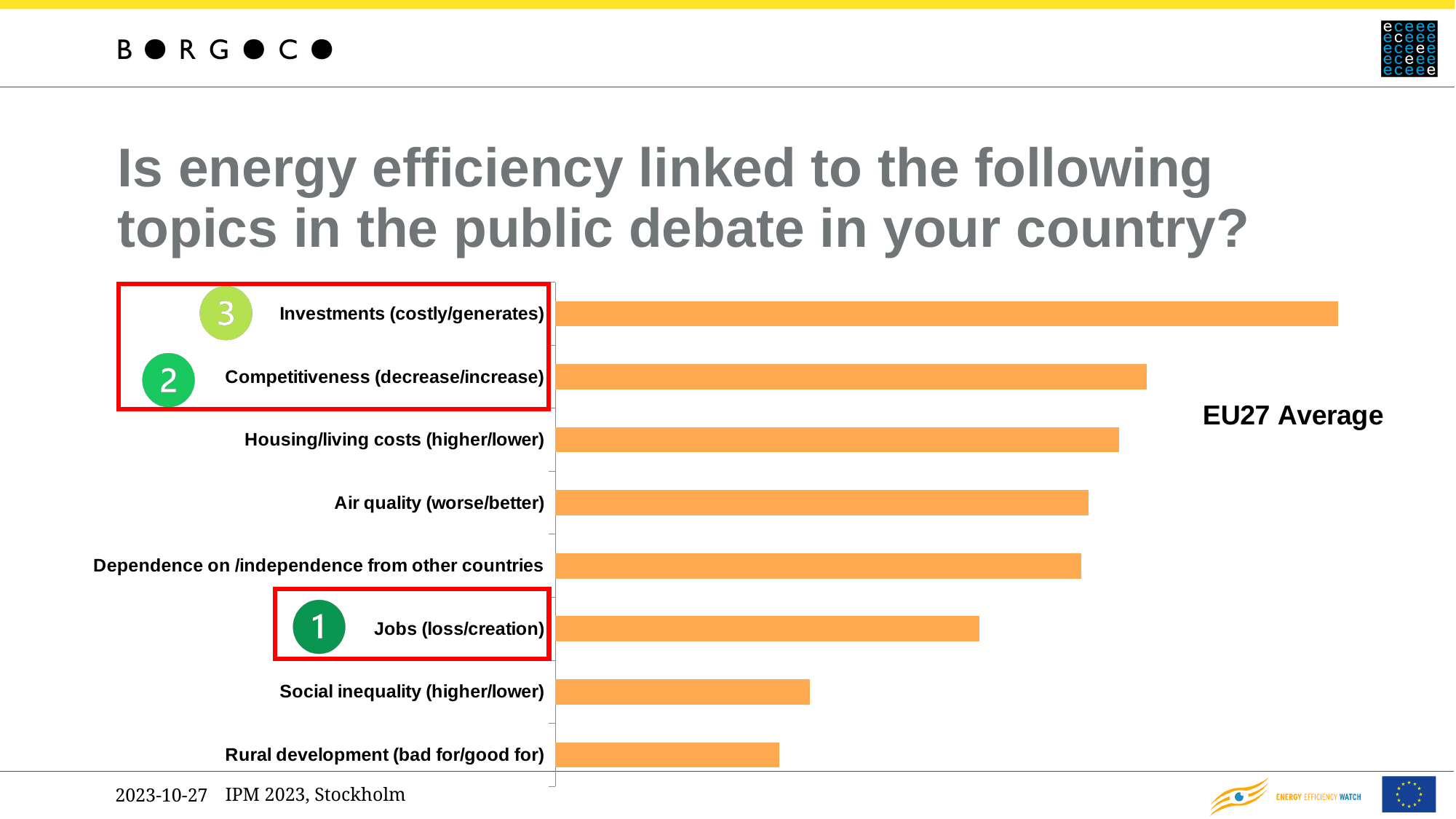
Which has the longer bar: Investments (costly/generates) or Jobs (loss/creation)? Investments (costly/generates) What colour are the bars in the chart? orange Which has the longer bar: Social inequality (higher/lower) or Housing/living costs (higher/lower)? Housing/living costs (higher/lower) Do the bar lengths increase or decrease going from the top category to the bottom category? decrease Which topic has the shortest bar in the chart? Rural development (bad for/good for) What label is shown next to the bars to indicate what the values represent? EU27 Average Which has the longer bar: Rural development (bad for/good for) or Air quality (worse/better)? Air quality (worse/better) What kind of chart is shown on the slide? bar chart How many topics (categories) are plotted in the chart? 8 Which topic has the longest bar in the chart? Investments (costly/generates)